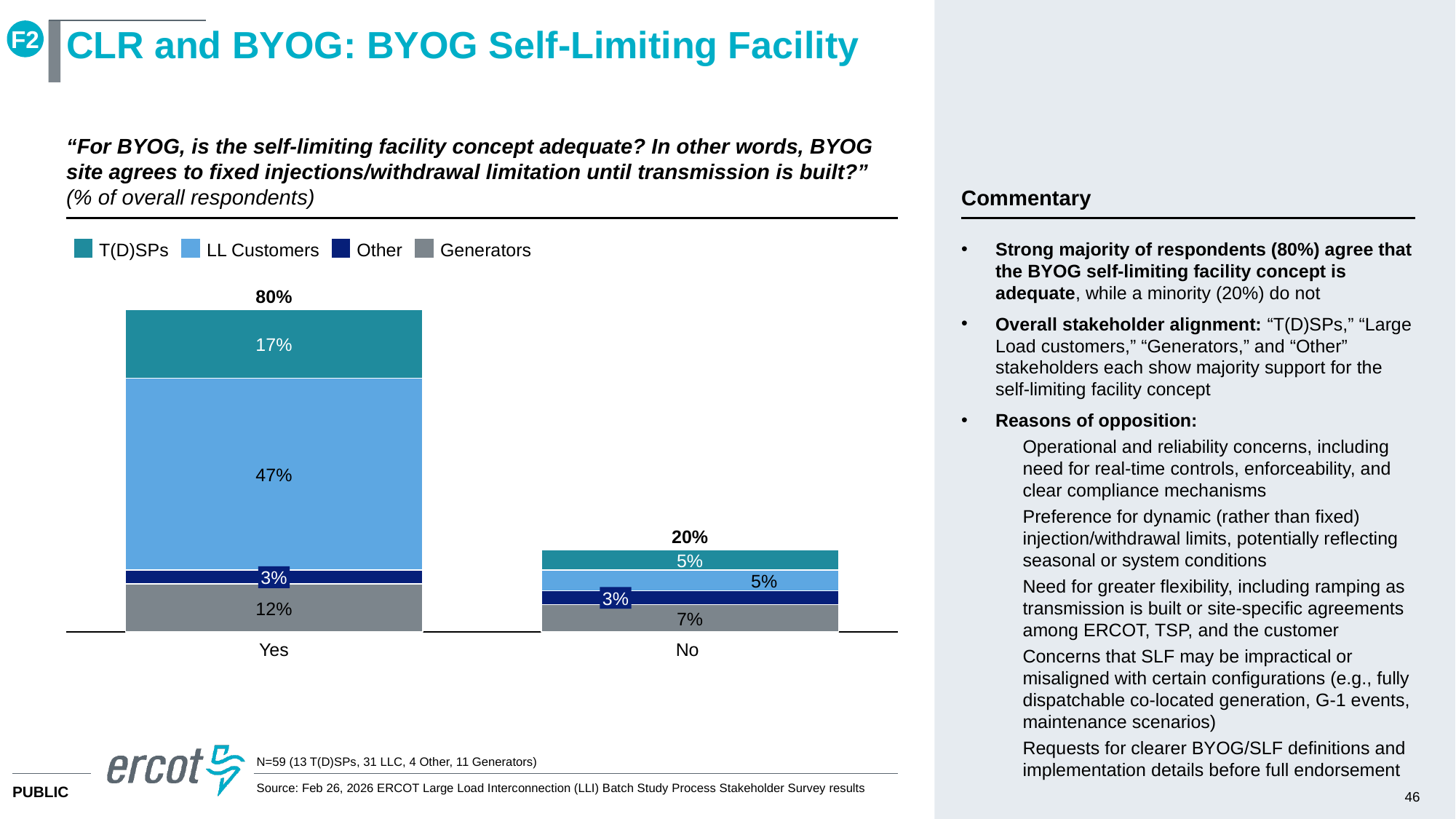
What percentage of respondents answered Yes in total? 80% How many response categories are shown on the x axis? 2 What is the difference between the Generators value for Yes and the Generators value for No? 5% Which response category has the higher total, Yes or No? Yes What is the Other value for the No bar? 3% What is the LL Customers value for the Yes bar? 47% What percentage of respondents answered No in total? 20% How many series does the legend list? 4 What is the difference between the Yes total and the No total? 60% What is the T(D)SPs value for the No bar? 5% What is the Generators value for the Yes bar? 12% What kind of chart is shown on the slide? Stacked bar chart